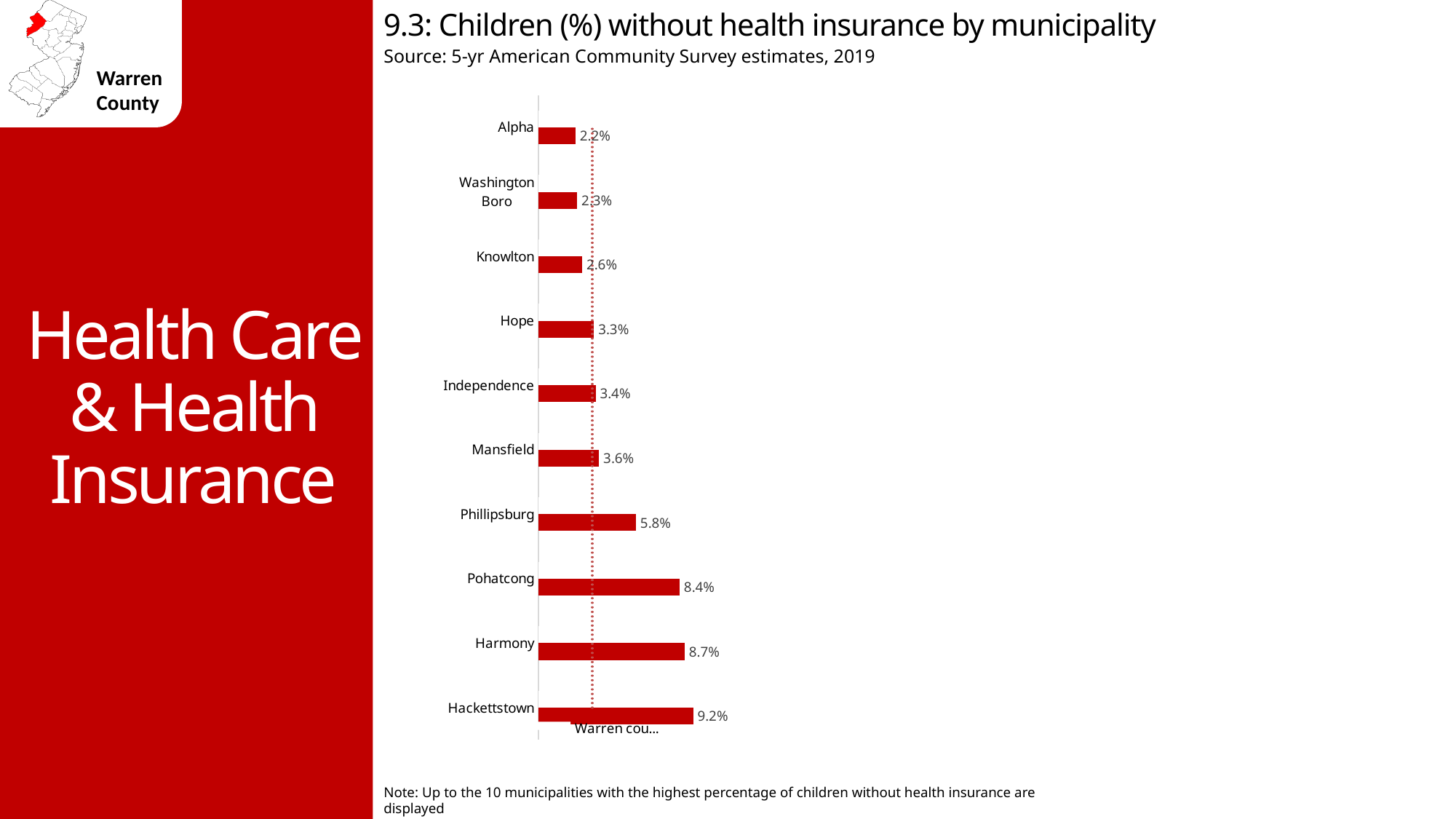
What percentage of children in Hackettstown are without health insurance? 9.2% How many municipalities are shown in the chart? 10 What is the value shown for Washington Boro? 2.3% What is the difference between the values for Pohatcong and Phillipsburg? 2.6% What is the difference between the values for Hackettstown and Harmony? 0.5% What is the title of the chart? 9.3: Children (%) without health insurance by municipality What kind of chart is shown on the slide? Bar chart Which municipality has the lowest percentage of children without health insurance? Alpha Which has a higher value, Hope or Pohatcong? Pohatcong Which municipality has the highest percentage of children without health insurance? Hackettstown What is the value shown for Phillipsburg? 5.8% Which has a higher value, Mansfield or Knowlton? Mansfield